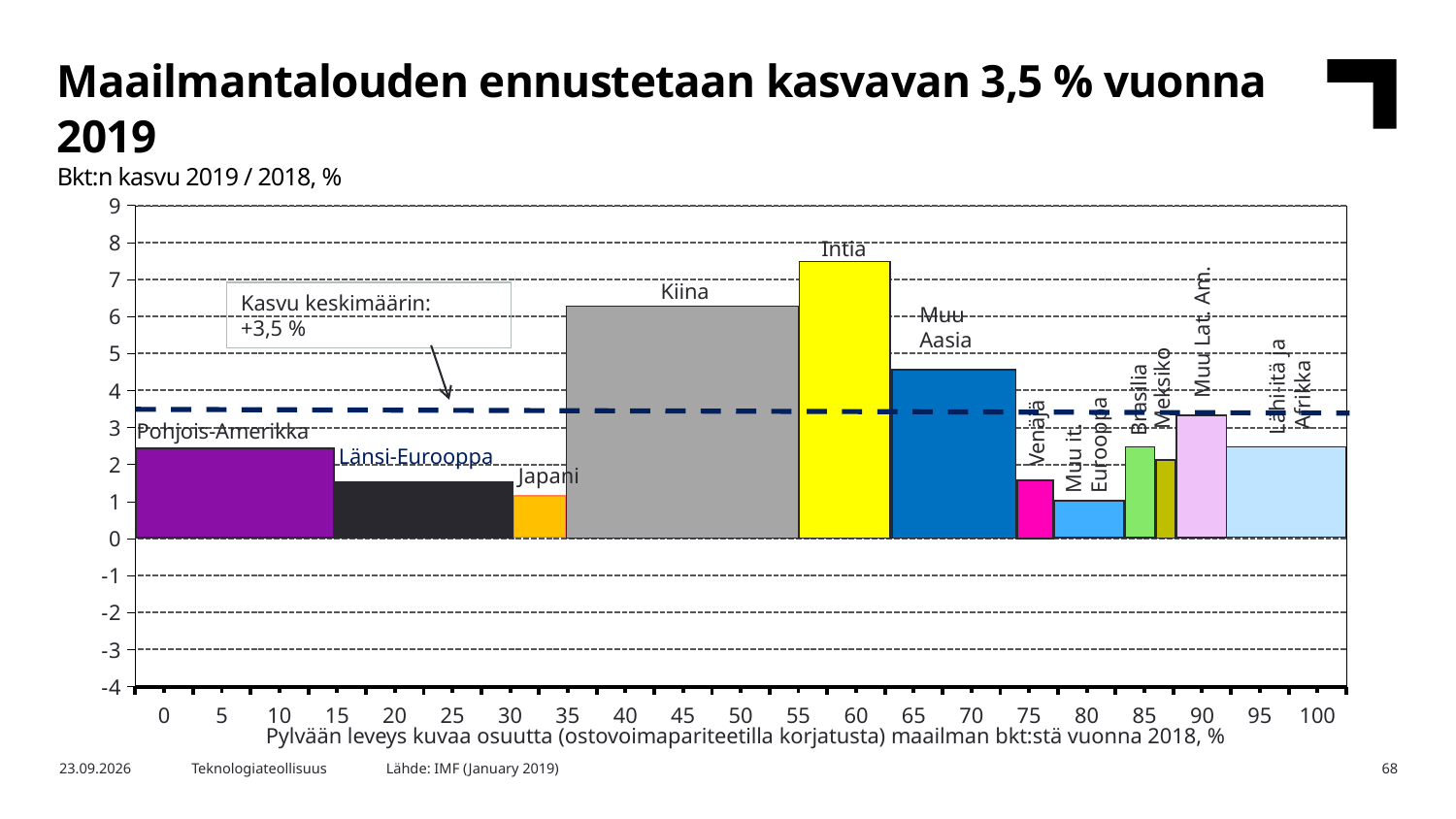
What kind of chart is shown on the slide? Bar chart Is the value for Japani greater or less than 2? less How many regions are shown as bars in the chart? 12 Which has the higher forecast growth, Kiina or Muu Aasia? Kiina Is the value for Muu Lat. Am. greater or less than 4? less Is the value for Muu Aasia greater or less than 4? greater Which region has the highest forecast GDP growth in the chart? Intia Which has the higher forecast growth, Pohjois-Amerikka or Japani? Pohjois-Amerikka What average growth rate does the dashed line in the chart represent? +3,5 %